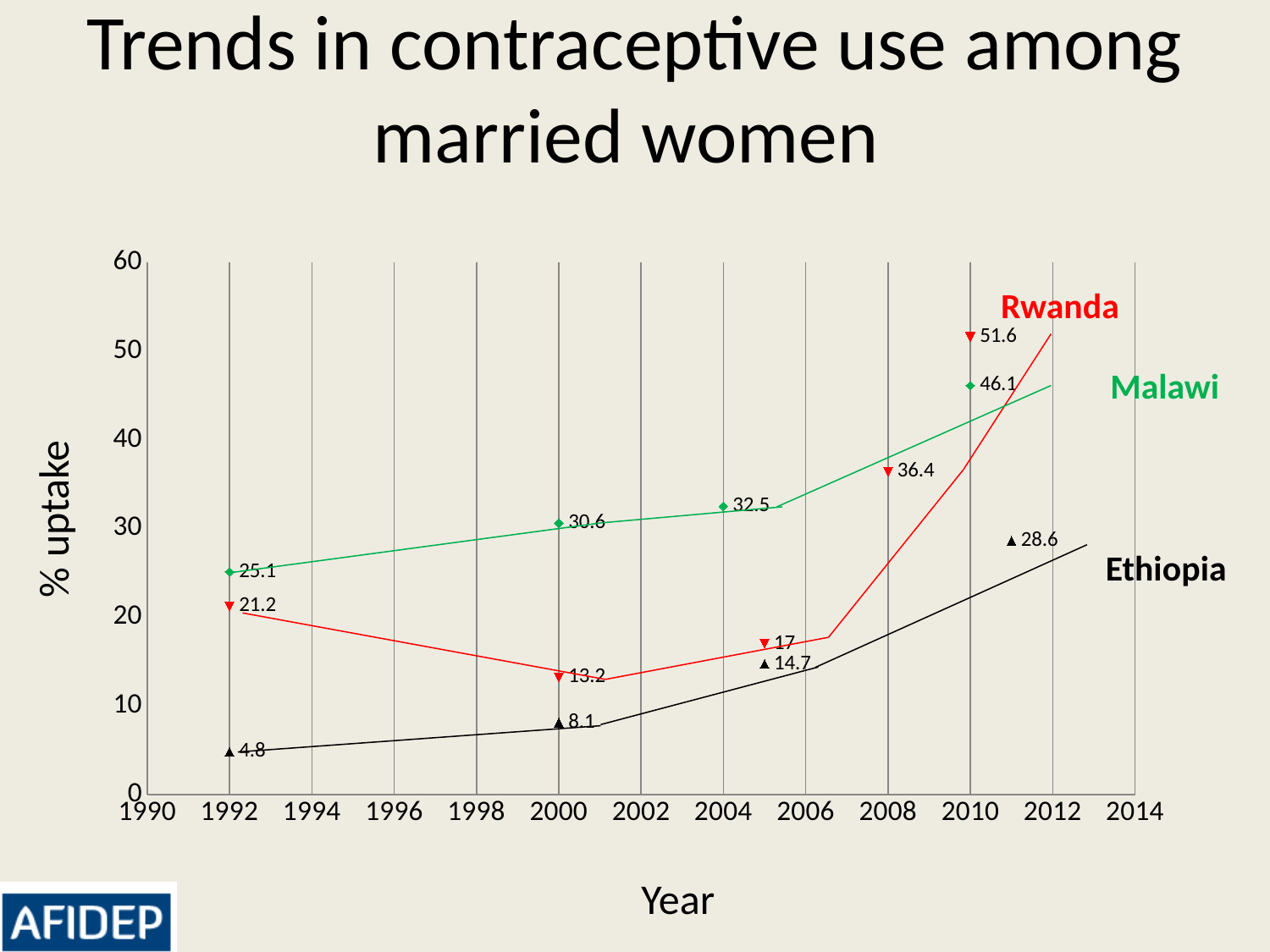
What is the % uptake for Rwanda in 2008? 36.4 What is the difference between Rwanda's % uptake in 2010 and Malawi's % uptake in 2010? 5.5 What is the % uptake for Malawi in 1992? 25.1 Which country has the highest % uptake in 2010? Rwanda Which is larger: Rwanda's % uptake in 2005 or Ethiopia's % uptake in 2005? Rwanda Does Ethiopia's % uptake rise or fall from 1992 to 2011? rise Which country has the lowest % uptake in 1992? Ethiopia What is the label of the y axis? % uptake How many countries are plotted on the chart? 3 What kind of chart is shown on the slide? line chart What is the % uptake for Rwanda in 2010? 51.6 What is the % uptake for Ethiopia in 2000? 8.1